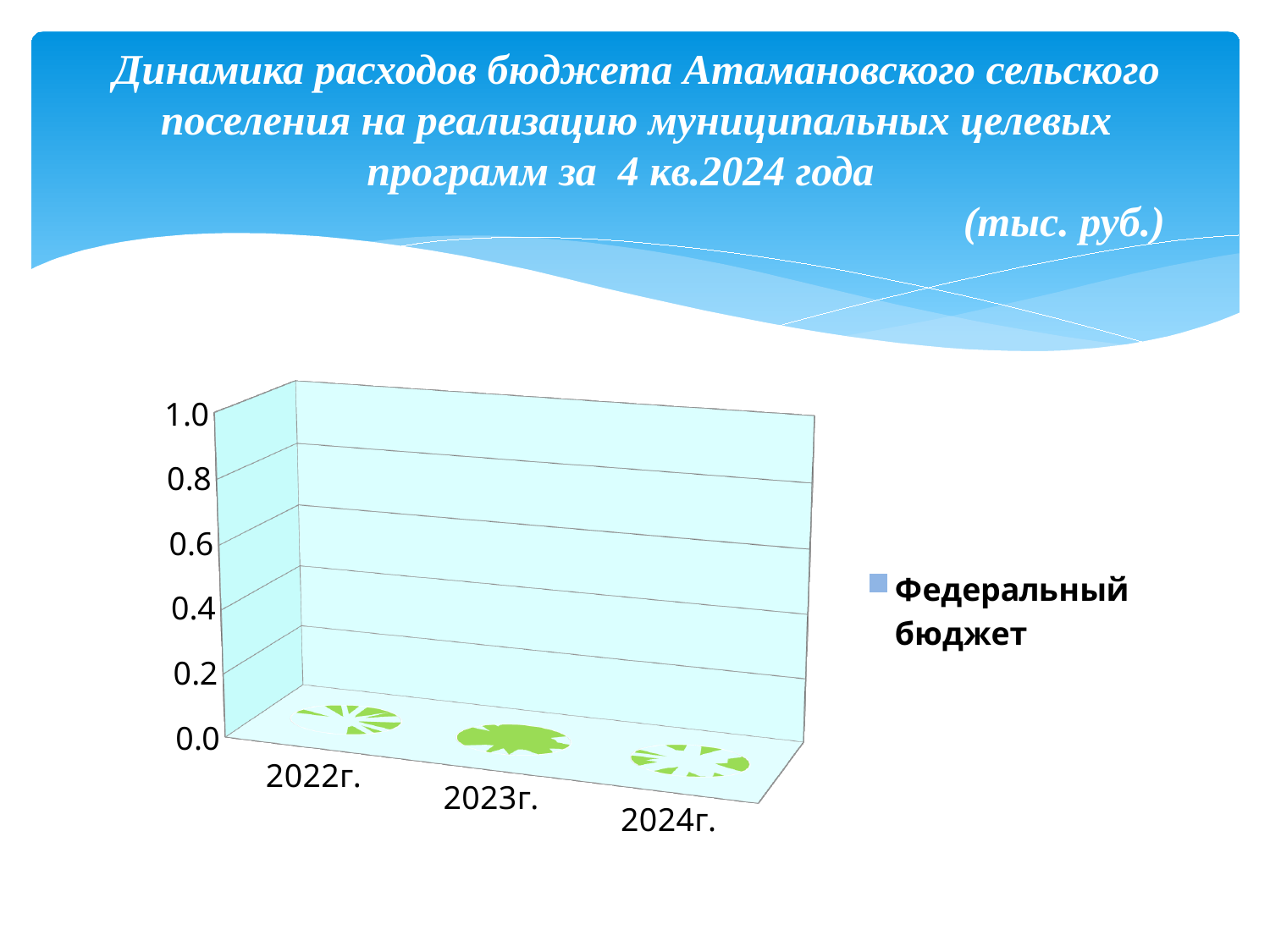
How many categories are shown on the x axis of the chart? 3 How many series does the chart's legend list? 1 What is the name of the series listed in the chart's legend? Федеральный бюджет Is the value for 2024г. greater or less than 0.2? less Is the value for 2022г. greater or less than 0.2? less Is the value for 2023г. greater or less than 0.4? less Which year is the first category on the x axis of the chart? 2022г. Which year is the last category on the x axis of the chart? 2024г. What is the highest tick value shown on the chart's vertical axis? 1.0 What kind of chart is shown on the slide? bar chart